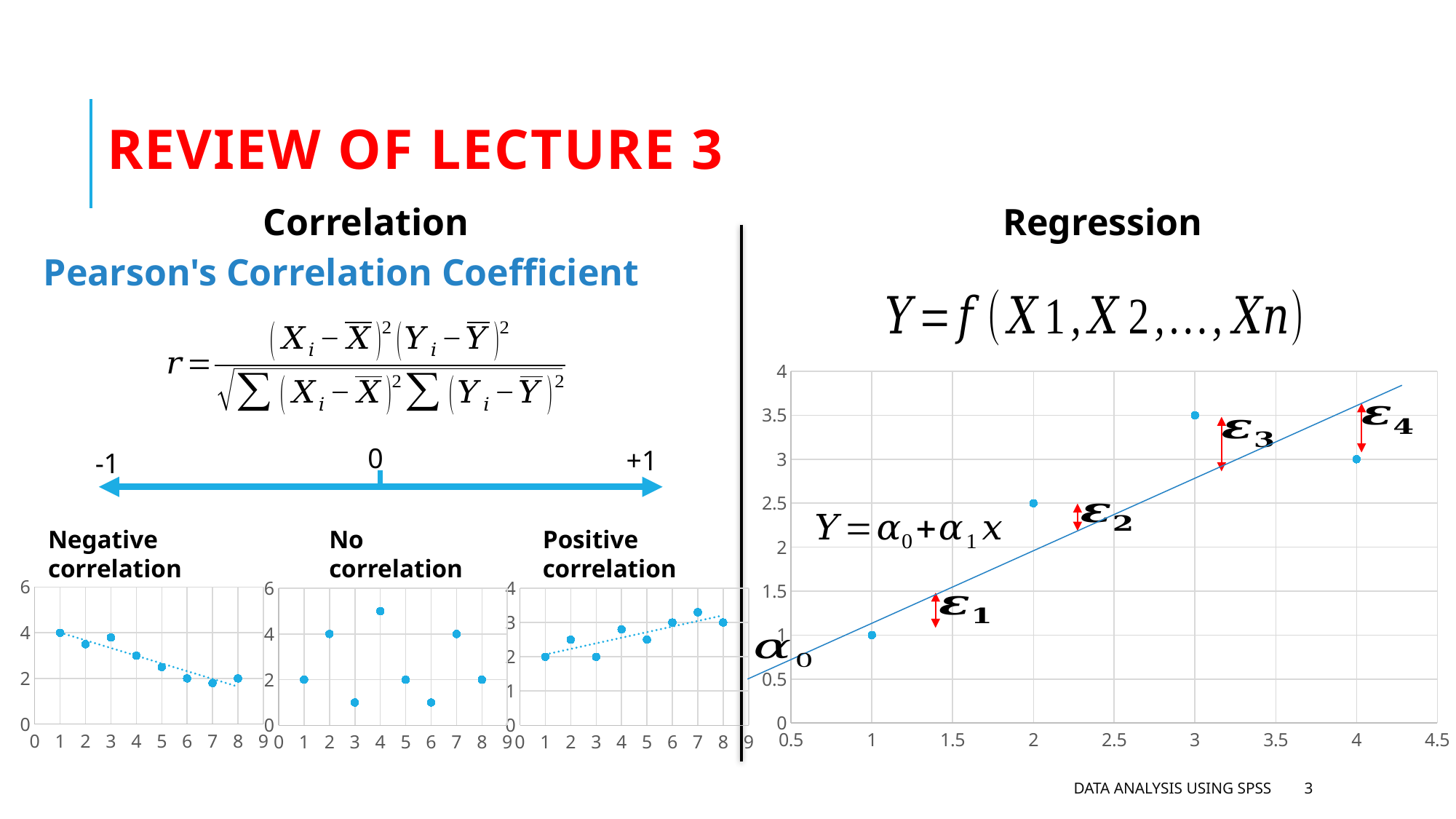
In the Regression chart, at which x value is the highest point plotted? 3 What kind of chart is the Negative correlation chart? scatter chart In the Regression chart, what is the y value of the point at x = 3? 3.5 How many data points are plotted in the Regression chart? 4 In the Regression chart, what is the y value of the point at x = 4? 3 In the Regression chart, what is the difference between the y values of the points at x = 3 and x = 4? 0.5 In the Regression chart, which point has the larger y value, the one at x = 2 or the one at x = 4? x = 4 In the Regression chart, at which x value is the lowest point plotted? 1 How many data points are plotted in the No correlation chart? 8 In the Regression chart, what is the y value of the point at x = 1? 1 Do the points in the Regression chart generally rise or fall as x increases? rise In the Positive correlation chart, what is the y value of the point at x = 6? 3